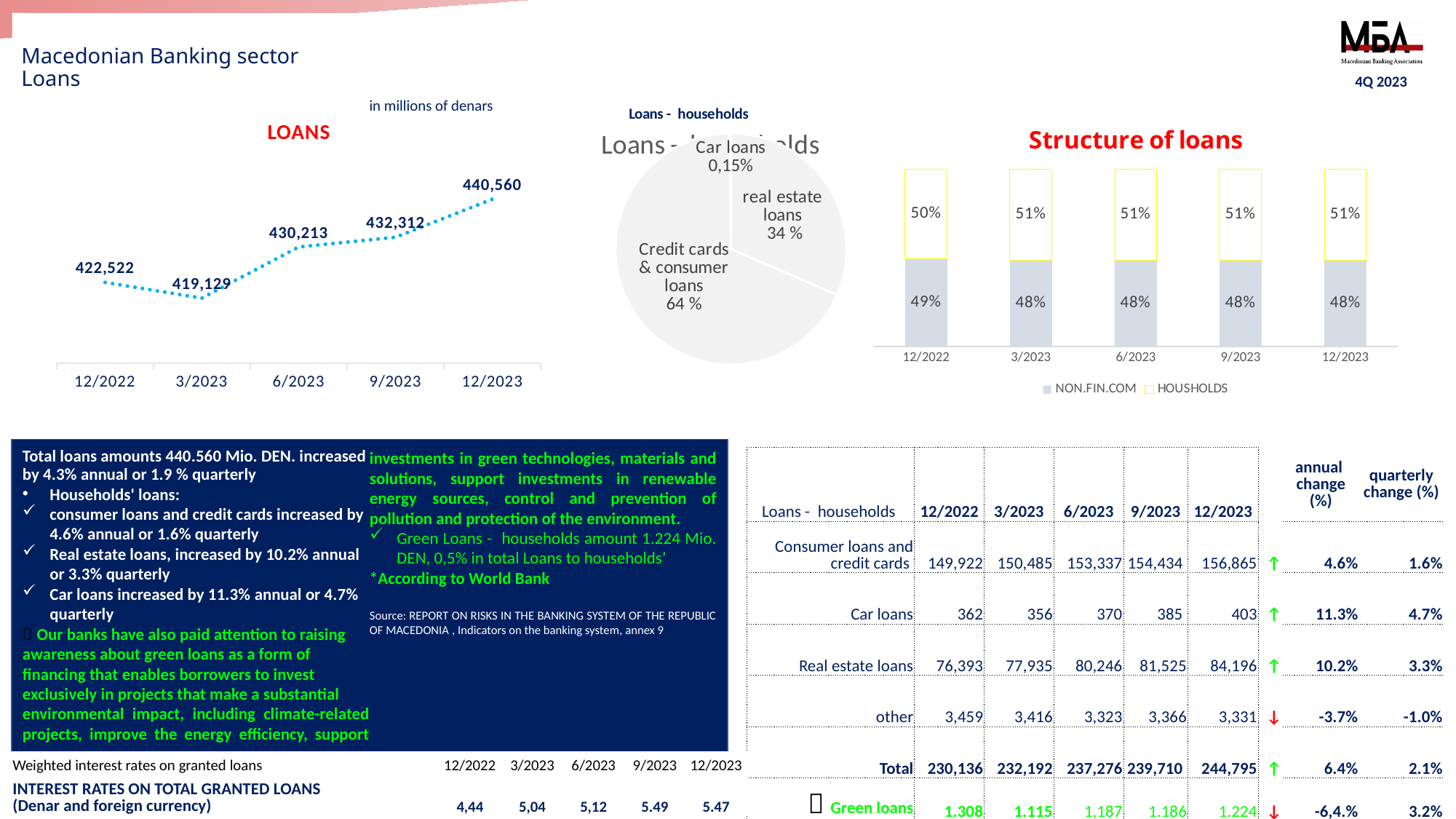
How many data points are plotted in the LOANS line chart? 5 How many series does the legend of the Structure of loans chart list? 2 In the Loans - households pie chart, which slice is the largest? Credit cards & consumer loans In the Loans - households pie chart, what share do real estate loans have? 34 % In the LOANS line chart, what is the difference between the 12/2023 value and the 12/2022 value? 18,038 What kind of chart is the LOANS chart? line chart In the LOANS line chart, what is the value for 12/2023? 440,560 In the Structure of loans chart, what is the NON.FIN.COM value for 12/2022? 49% How many slices does the Loans - households pie chart have? 3 In the Structure of loans chart, which is larger for 12/2023: HOUSHOLDS or NON.FIN.COM? HOUSHOLDS In the LOANS line chart, which period has the lowest value? 3/2023 In the LOANS line chart, do the values rise or fall from 3/2023 to 12/2023? rise